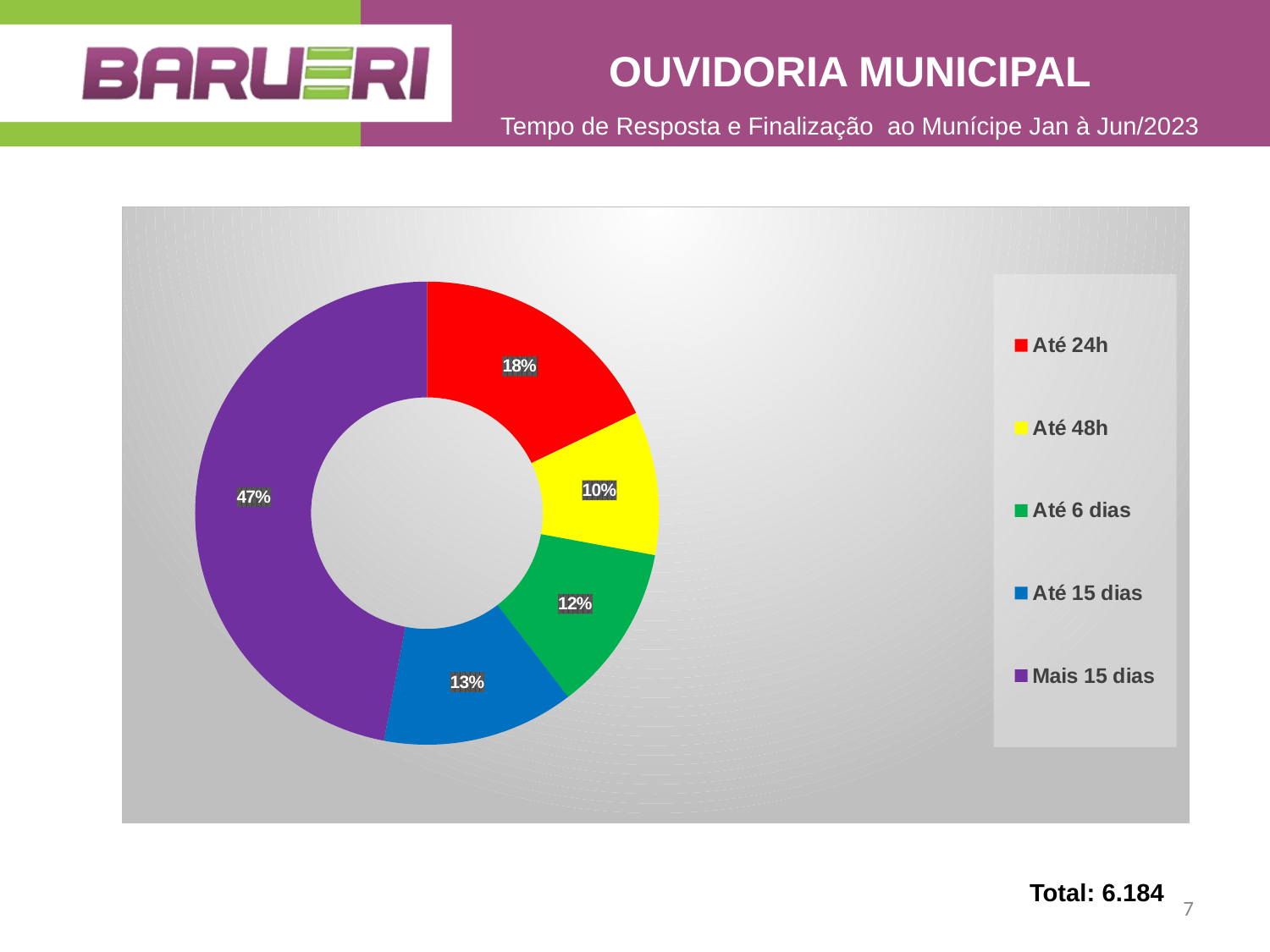
What is the value shown for 'Até 6 dias'? 12% What is the value shown for 'Até 48h'? 10% Which is larger, the share for 'Até 24h' or the share for 'Até 15 dias'? Até 24h What is the value shown for 'Até 15 dias'? 13% How many categories does the legend list? 5 What colour is used for the 'Até 6 dias' slice? Green What share of the pie does the 'Mais 15 dias' slice represent? 47% What is the value shown for 'Até 24h'? 18% What kind of chart is shown on the slide? Pie chart (doughnut) Which category has the smallest share of the pie? Até 48h What is the difference in percentage points between 'Mais 15 dias' and 'Até 24h'? 29 Which category has the largest share of the pie? Mais 15 dias